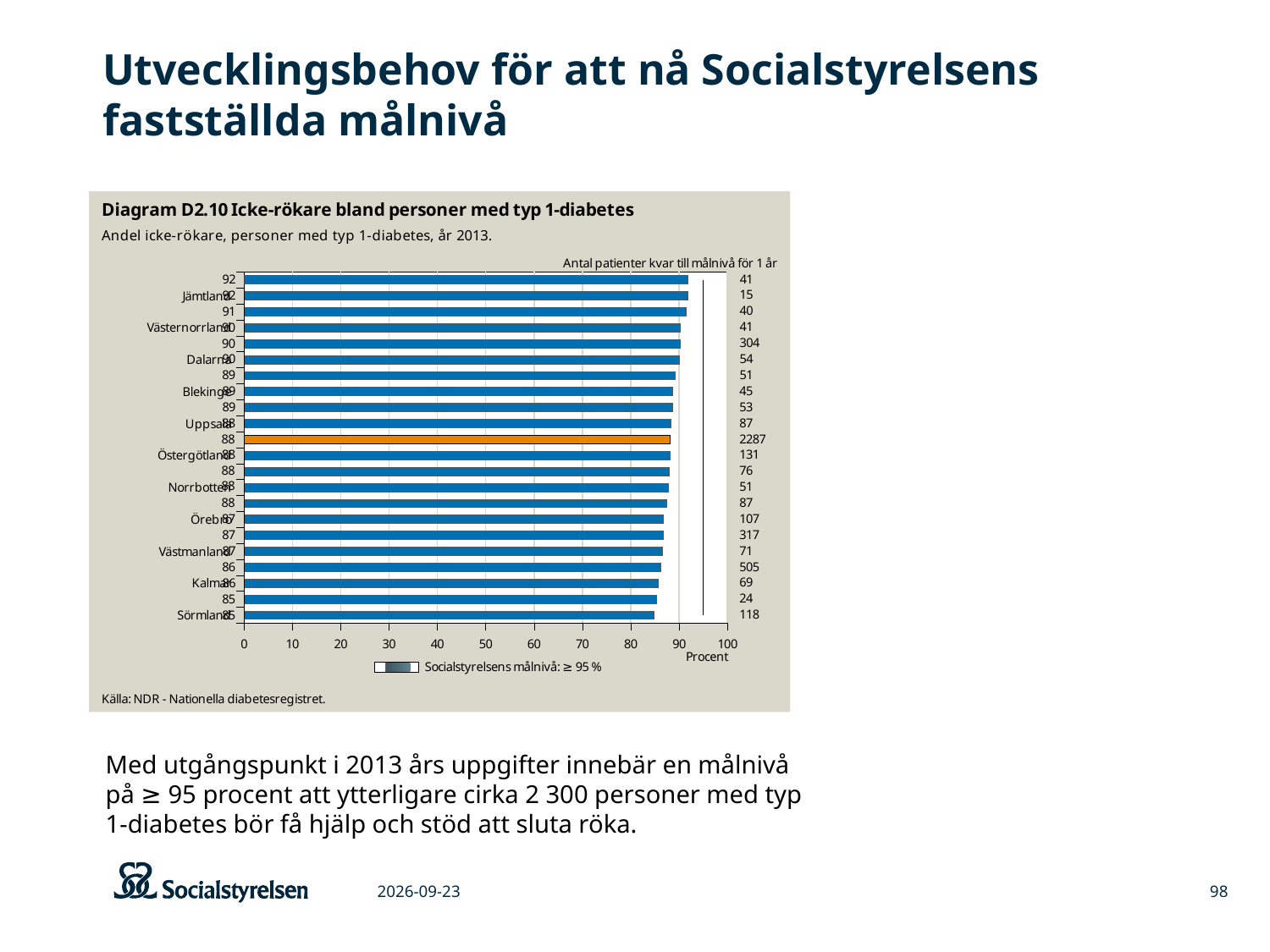
Which has a higher share of non-smokers in Diagram D2.10, Dalarna or Kalmar? Dalarna What is the value for Kalmar in Diagram D2.10? 86 What target level (målnivå) from Socialstyrelsen is indicated in the legend of Diagram D2.10? ≥ 95 % What is the lowest percentage value shown in Diagram D2.10? 85 What is the difference in percentage points between Jämtland and Sörmland in Diagram D2.10? 7 What kind of chart is shown in Diagram D2.10? bar chart How many patients remain to reach the target level for the orange-highlighted bar? 2287 What is the highest percentage value shown in Diagram D2.10? 92 What is the share of non-smokers (percent) for Sörmland in Diagram D2.10? 85 How many bars are plotted in Diagram D2.10? 22 How many patients remain to reach the target level for Jämtland, according to the right-hand column? 15 What is the share of non-smokers (percent) for Jämtland in Diagram D2.10? 92